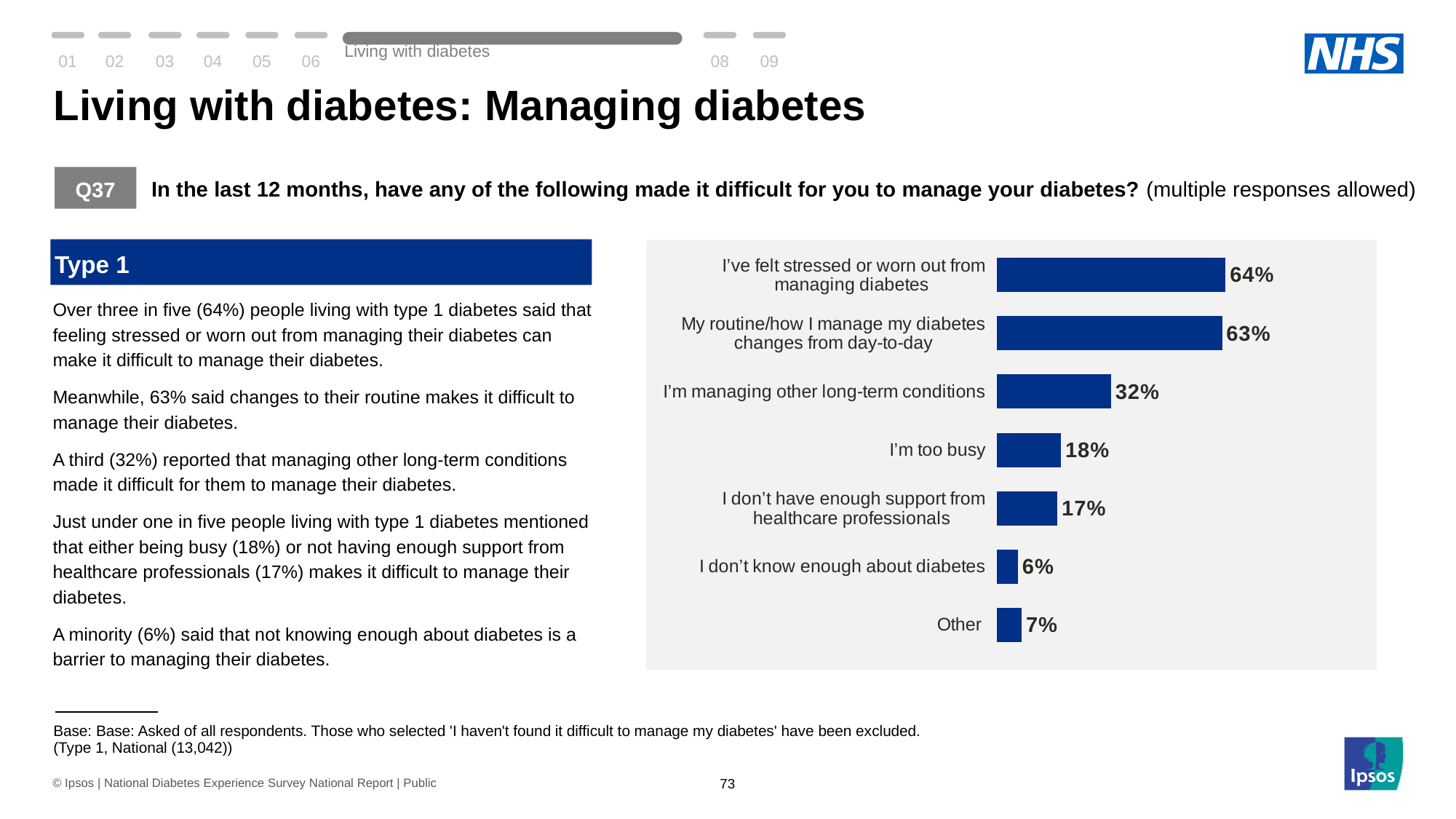
What is the value for 'Other'? 7% What percentage of respondents said they've felt stressed or worn out from managing diabetes? 64% Which category has the highest value in the chart? I've felt stressed or worn out from managing diabetes What is the value for 'I'm managing other long-term conditions'? 32% Which category has the lowest value in the chart? I don't know enough about diabetes What percentage selected 'I don't have enough support from healthcare professionals'? 17% Which group of people living with diabetes does the chart cover? Type 1 What is the difference between the values for 'I've felt stressed or worn out from managing diabetes' and 'My routine/how I manage my diabetes changes from day-to-day'? 1 percentage point How many categories are shown in the chart? 7 What type of chart is shown on the slide? Bar chart Which is larger: the value for 'I'm managing other long-term conditions' or the value for 'I'm too busy'? I'm managing other long-term conditions What is the difference between the values for 'I'm too busy' and 'I don't know enough about diabetes'? 12 percentage points